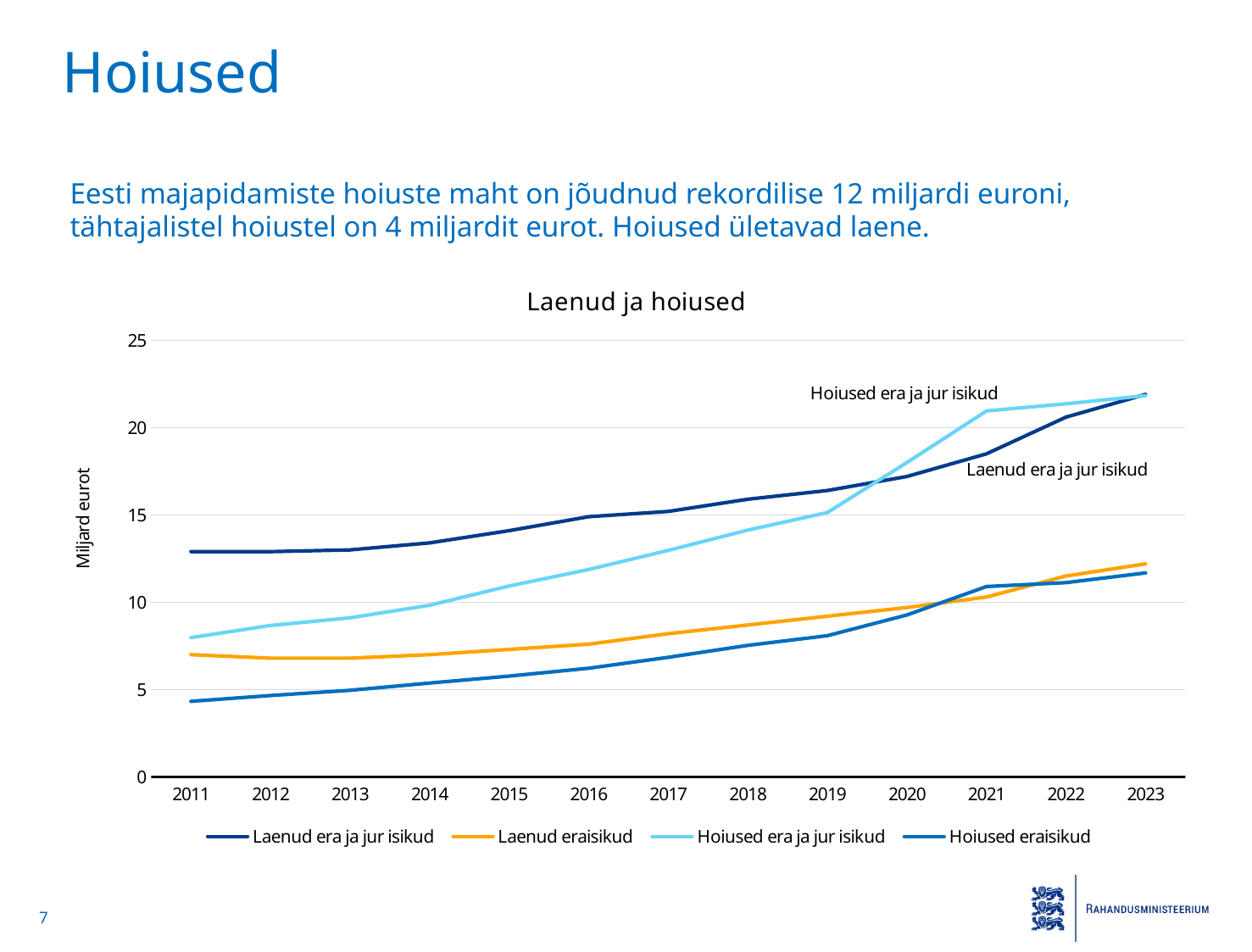
How many series does the legend list? 4 Is the value for Hoiused era ja jur isikud in 2011 greater or less than 10? less What is the label of the vertical axis? Miljard eurot In 2021, which is larger: Hoiused era ja jur isikud or Laenud era ja jur isikud? Hoiused era ja jur isikud How many years are shown on the x axis? 13 What is the title of the chart? Laenud ja hoiused Is the value for Laenud era ja jur isikud in 2011 greater or less than 10? greater Which series has the highest value in 2011? Laenud era ja jur isikud Does the Hoiused eraisikud series rise or fall from 2011 to 2023? rise What kind of chart is shown on the slide? line chart Which series has the lowest value in 2011? Hoiused eraisikud Is the value for Hoiused era ja jur isikud in 2023 greater or less than 20? greater